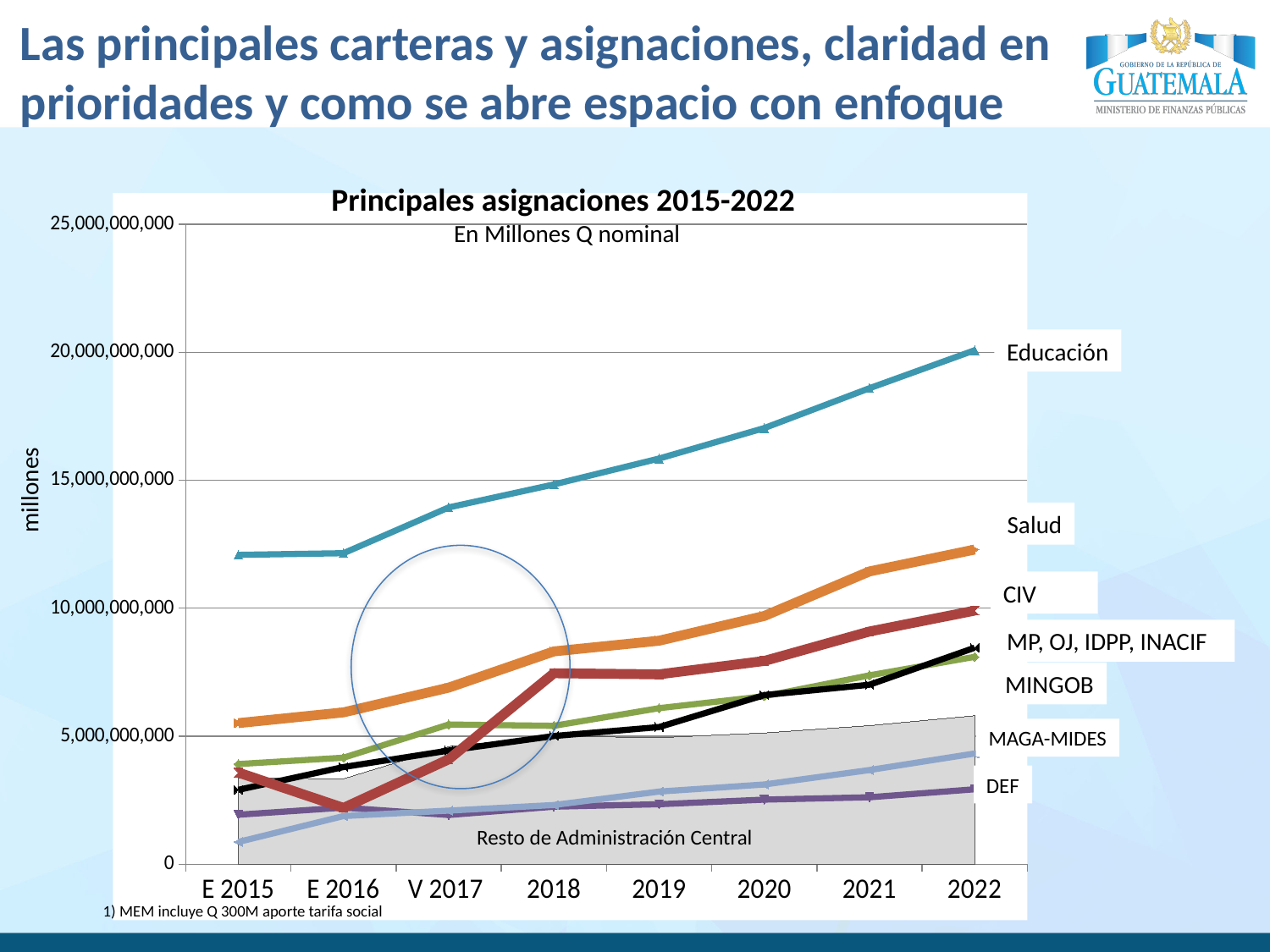
How many periods are shown along the x axis of the chart? 8 Does the Educación series rise or fall from E 2015 to 2022? rises Which series has the highest value in 2022? Educación Is the value for Educación in E 2015 greater or less than 10,000,000,000? greater What kind of chart is shown on the slide? combination line and area chart Does the CIV series rise or fall from E 2015 to E 2016? falls In 2022, which is larger, Salud or CIV? Salud Which labeled line series has the lowest value in 2022? DEF Is the value for Educación in 2021 greater or less than 20,000,000,000? less What is the title of the chart? Principales asignaciones 2015-2022 Is the value for CIV in E 2016 greater or less than 5,000,000,000? less